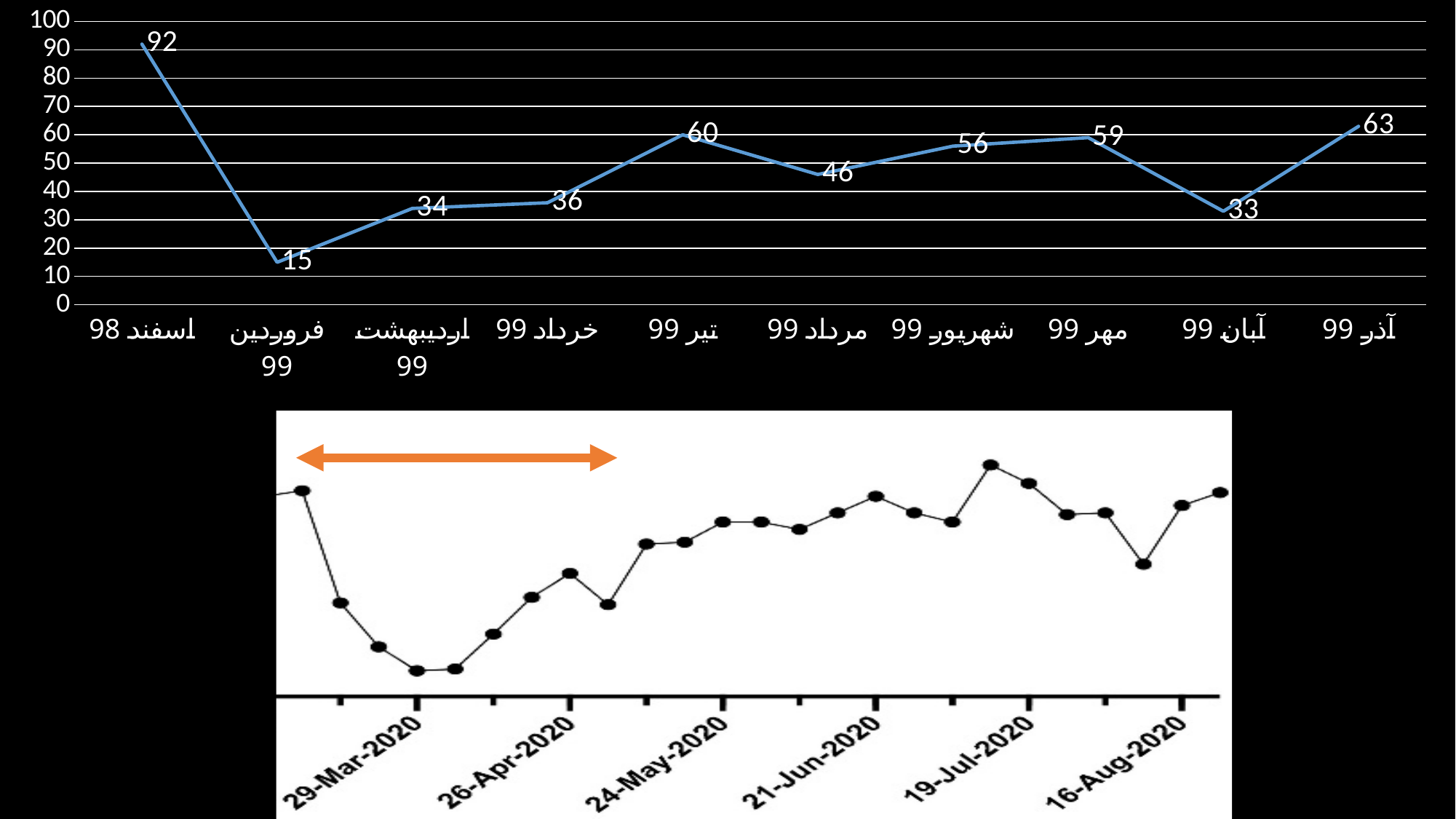
In the top chart, what is the value for فروردین 99? 15 In the top chart, which is larger, the value for مهر 99 or the value for آبان 99? مهر 99 What kind of chart is the top chart? line chart In the top chart, do the values rise or fall from اردیبهشت 99 to تیر 99? rise In the top chart, which category has the highest value? اسفند 98 In the top chart, what is the value for آذر 99? 63 In the top chart, what is the difference between the values for اسفند 98 and فروردین 99? 77 In the top chart, what is the value for تیر 99? 60 In the top chart, which category has the lowest value? فروردین 99 What is the first date label on the x axis of the bottom chart? 29-Mar-2020 In the top chart, how many data points are plotted? 10 In the top chart, what is the value for اسفند 98? 92